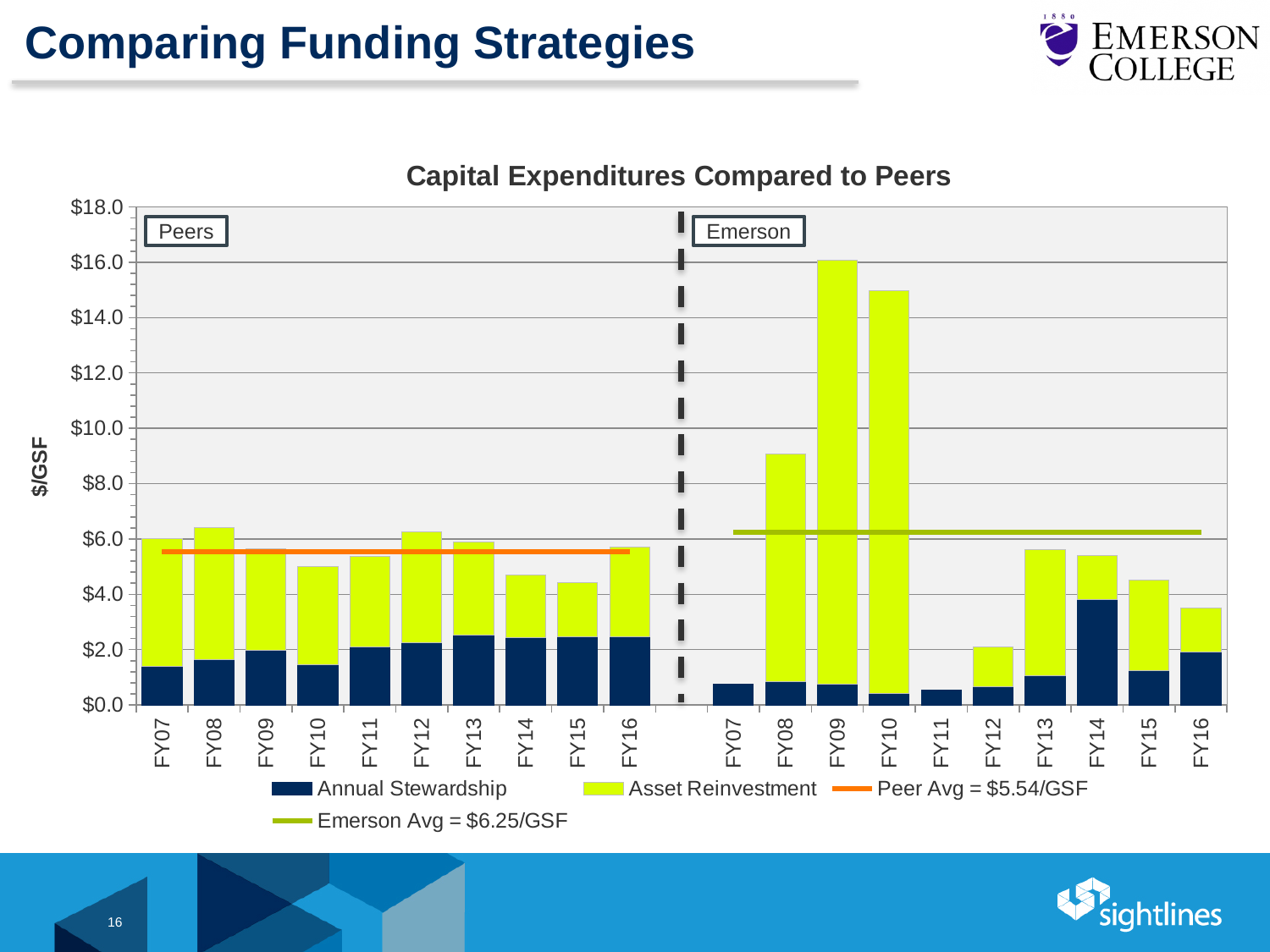
Which fiscal year bar has the highest total capital expenditure on the chart? Emerson FY09 What is the title of the chart? Capital Expenditures Compared to Peers What is the Emerson Avg value shown in the legend? $6.25/GSF Is the total value for Emerson FY12 greater or less than $4.0? less How many entries does the chart legend list? 4 Which fiscal year bar has the lowest total capital expenditure on the chart? Emerson FY11 What is the Peer Avg value shown in the legend? $5.54/GSF Which is larger, the Emerson Avg or the Peer Avg? Emerson Avg What is the difference between the Emerson Avg and the Peer Avg? $0.71/GSF What type of chart is shown on the slide? Stacked bar chart Do the Emerson total values rise or fall from FY14 to FY16? fall Is the total value for Emerson FY08 greater or less than $8.0? greater